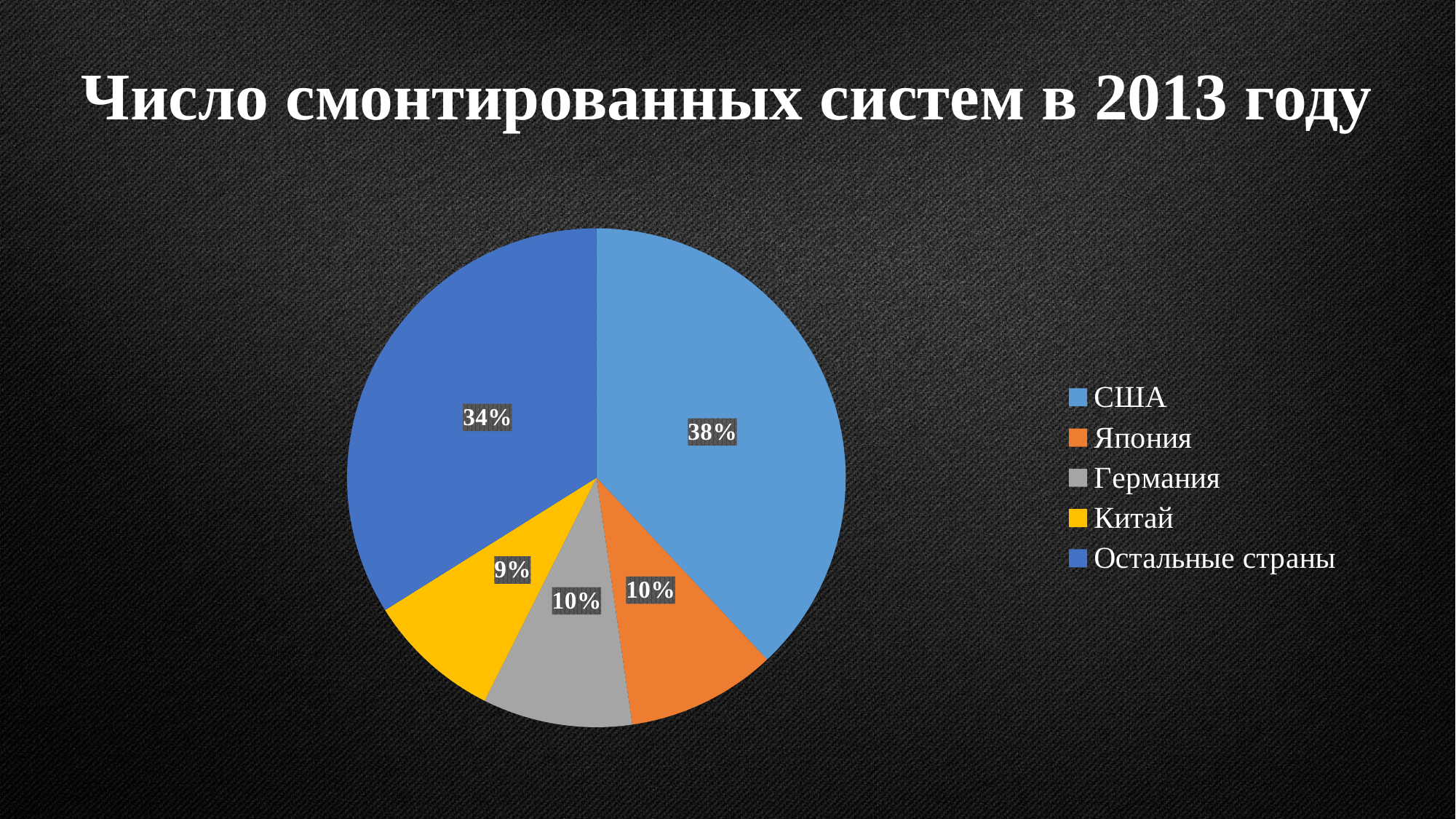
What is the difference in percentage points between the США slice and the Остальные страны slice? 4% How many categories does the legend list? 5 What share of the pie does Остальные страны (other countries) have? 34% What share of the pie does Япония (Japan) have? 10% What share of the pie does Китай (China) have? 9% What kind of chart is shown on the slide? Pie chart Which category has the largest slice of the pie? США What is the title of the chart on the slide? Число смонтированных систем в 2013 году Which category has the smallest slice of the pie? Китай Which is larger, the slice for США or the slice for Остальные страны? США